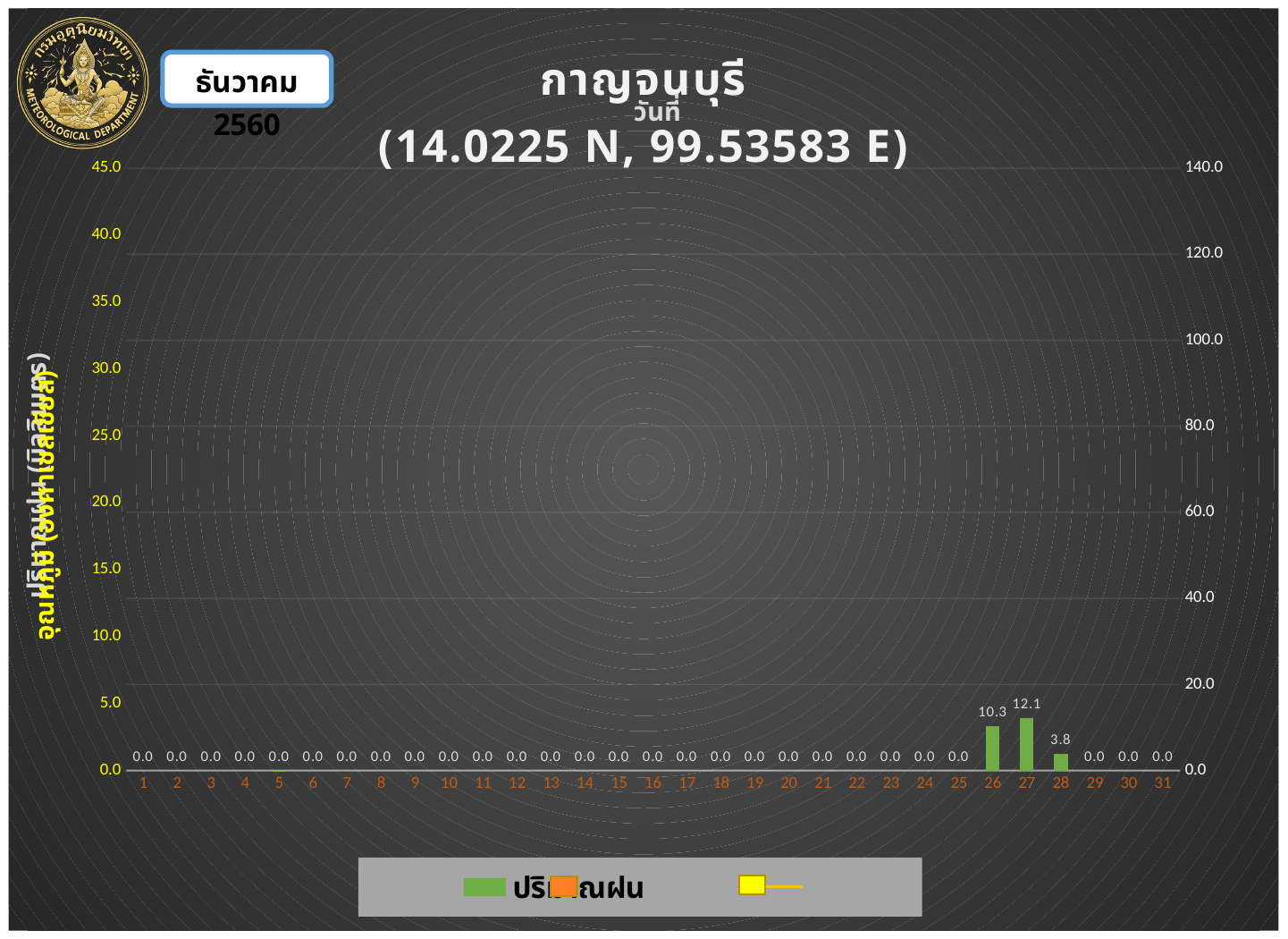
What is the difference between the rainfall values for day 26 and day 28? 6.5 How many days are shown on the x axis? 31 What is the rainfall value shown for day 26? 10.3 What is the rainfall value shown for day 28? 3.8 What is the highest value shown on the right-hand axis? 140.0 Which day has the highest rainfall value? 27 Which is larger, the rainfall value for day 26 or for day 28? day 26 What kind of chart is shown on the slide? bar chart What is the rainfall value shown for day 27? 12.1 What is the difference between the rainfall values for day 27 and day 26? 1.8 What is the rainfall value shown for day 15? 0.0 Is the rainfall value for day 27 greater or less than 15.0 on the left axis? less